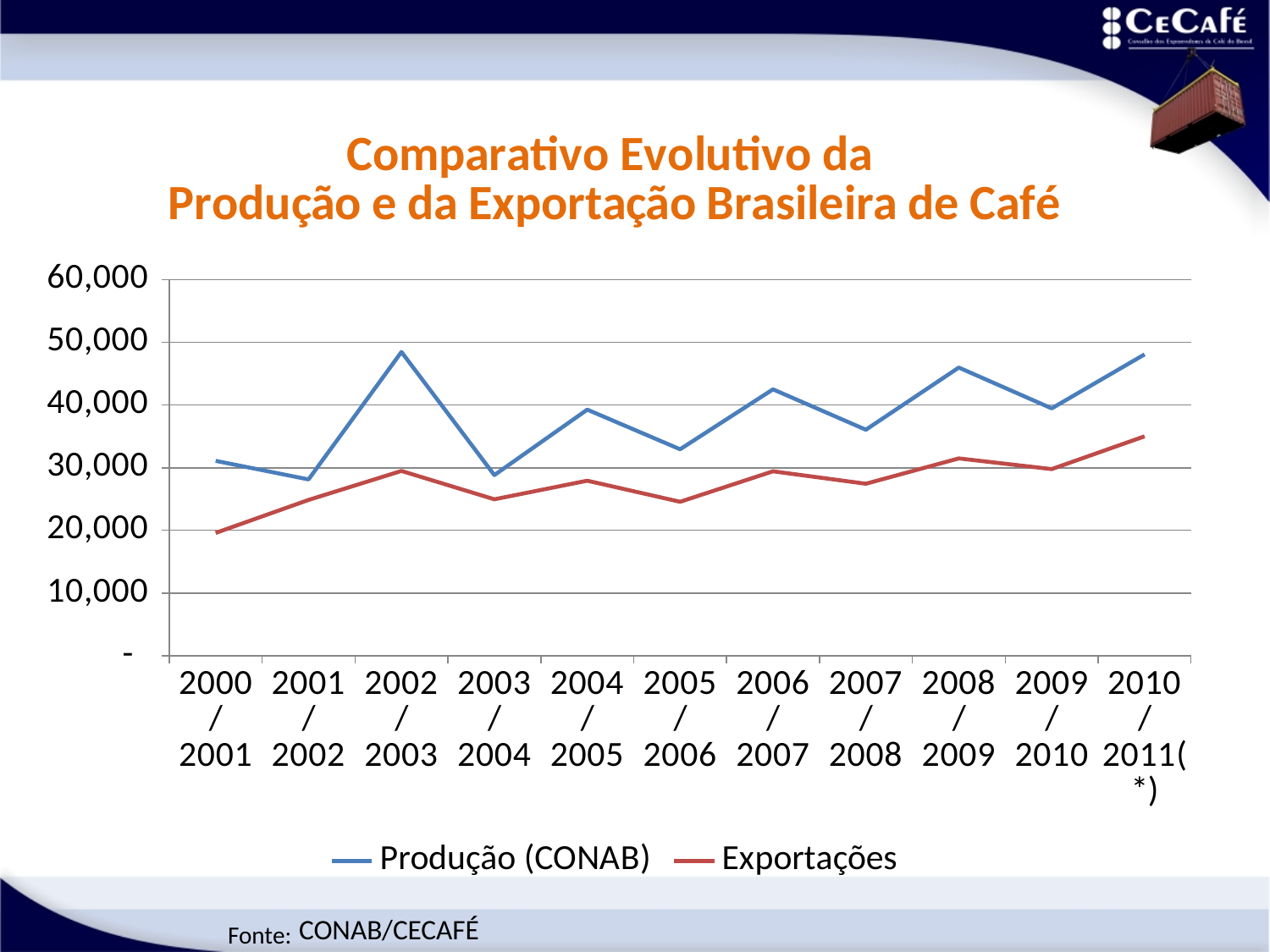
Is the Exportações value for 2005/2006 greater or less than 30,000? less Does the Exportações line rise or fall from 2000/2001 to 2002/2003? rise In which crop year is the Exportações value lowest? 2000/2001 What kind of chart is shown on the slide? line chart In which crop year is the Exportações value highest? 2010/2011(*) How many crop-year categories are shown on the x axis? 11 Is the Produção (CONAB) value for 2008/2009 greater or less than 40,000? greater Which colour is used for the Exportações line? red How many series does the legend list? 2 Is the Produção (CONAB) value for 2002/2003 greater or less than 40,000? greater In 2002/2003, which series has the larger value, Produção (CONAB) or Exportações? Produção (CONAB)